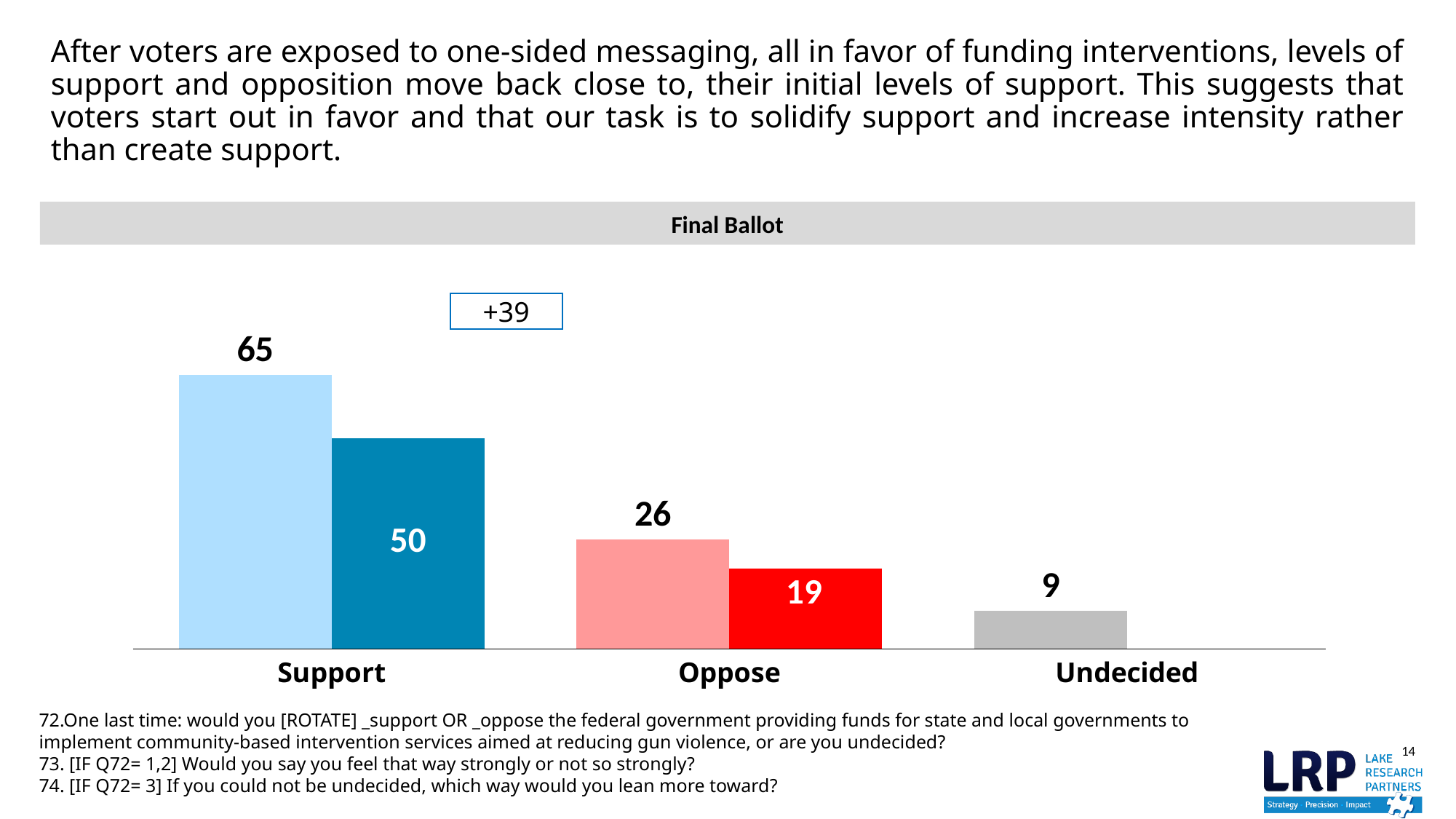
What is the value for Undecided? 9 Which category has the lowest value on the chart? Undecided What value is printed on the dark blue bar in the Support group? 50 What value is printed on the dark red bar in the Oppose group? 19 Which is larger, the dark blue Support bar or the dark red Oppose bar? dark blue Support bar What is the title of the chart? Final Ballot What is the value shown above the light red bar for Oppose? 26 Which category has the highest value on the chart? Support What is the difference between the light blue Support value (65) and the light red Oppose value (26)? 39 What is the value shown above the light blue bar for Support? 65 What number is shown in the boxed label above the Support bars? +39 What type of chart is shown on the slide? bar chart